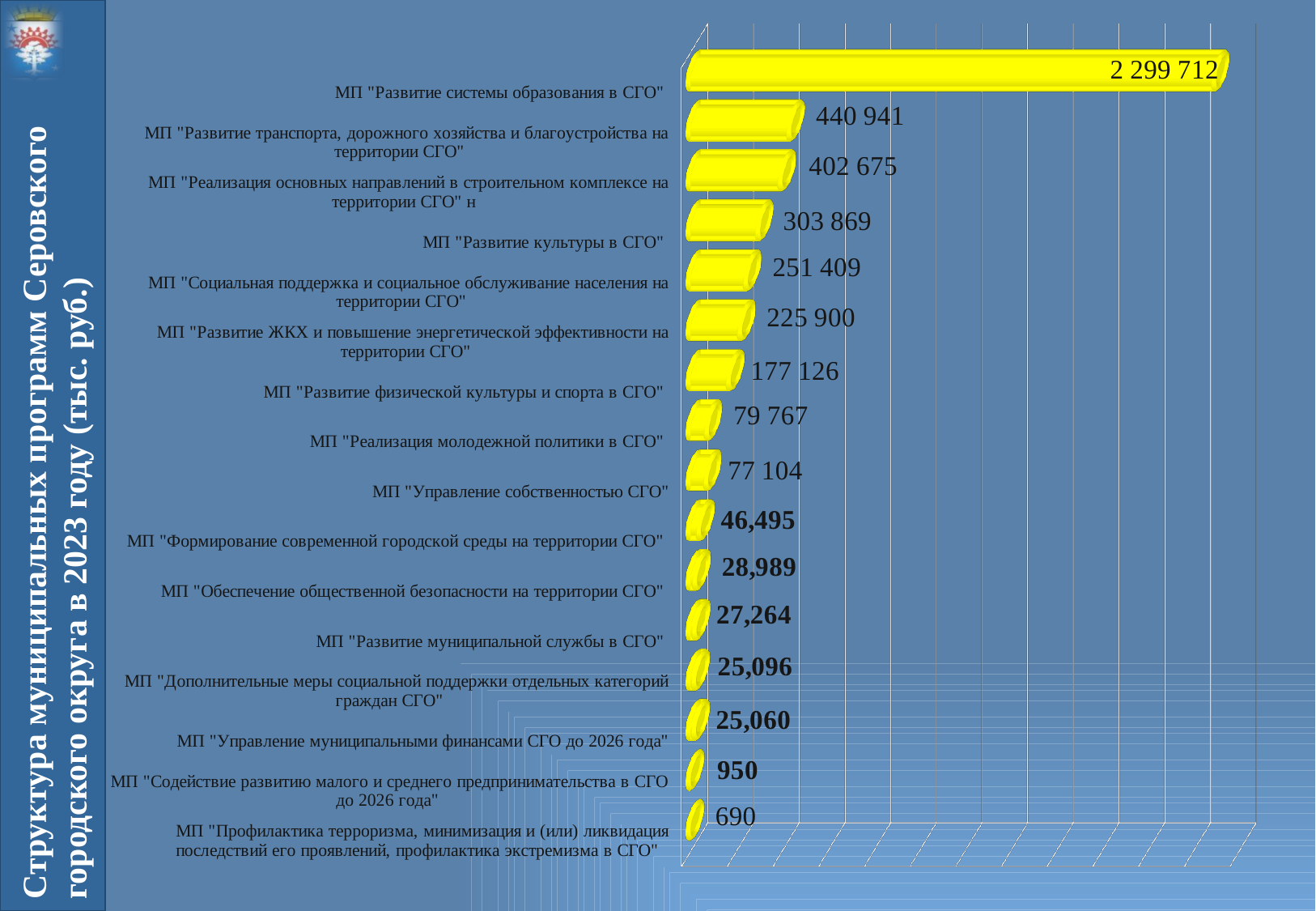
What is the value for МП "Обеспечение общественной безопасности на территории СГО"? 28,989 What type of chart is shown on the slide? Bar chart What is the title of the slide? Структура муниципальных программ Серовского городского округа в 2023 году (тыс. руб.) Which is larger: the value for МП "Социальная поддержка и социальное обслуживание населения на территории СГО" or МП "Развитие ЖКХ и повышение энергетической эффективности на территории СГО"? МП "Социальная поддержка и социальное обслуживание населения на территории СГО" Which program has the lowest value? МП "Профилактика терроризма, минимизация и (или) ликвидация последствий его проявлений, профилактика экстремизма в СГО" What is the value for МП "Развитие системы образования в СГО"? 2 299 712 What is the difference between the values for МП "Содействие развитию малого и среднего предпринимательства в СГО до 2026 года" and МП "Профилактика терроризма, минимизация и (или) ликвидация последствий его проявлений, профилактика экстремизма в СГО"? 260 What is the difference between the values for МП "Развитие транспорта, дорожного хозяйства и благоустройства на территории СГО" and МП "Реализация основных направлений в строительном комплексе на территории СГО"? 38 266 What is the value for МП "Развитие физической культуры и спорта в СГО"? 177 126 How many programs (categories) are shown in the chart? 16 Which program has the highest value? МП "Развитие системы образования в СГО" What is the value for МП "Развитие культуры в СГО"? 303 869